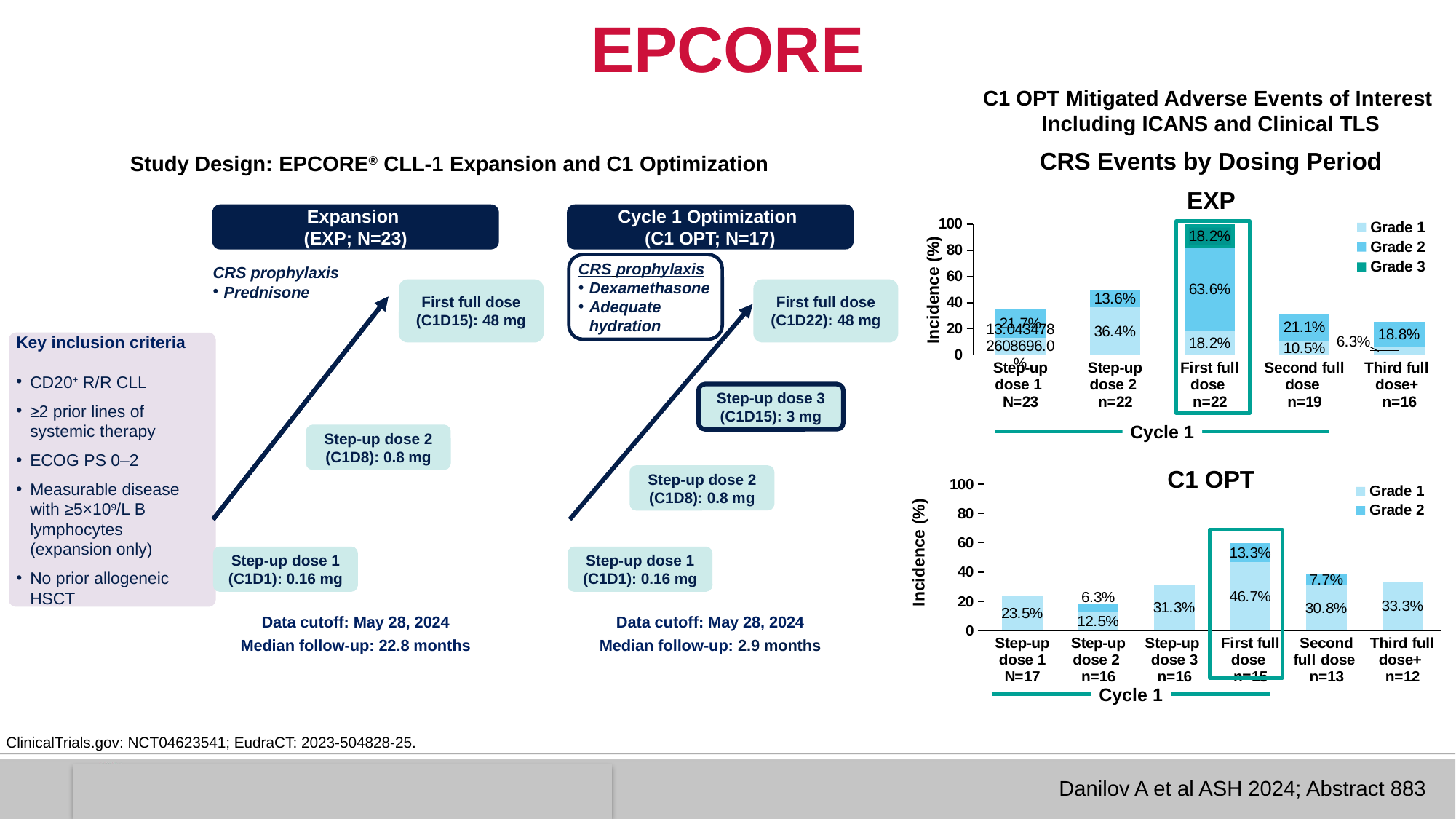
In the EXP chart, what is the difference in Grade 2 CRS incidence between the Second full dose and Step-up dose 2? 7.5 percentage points In the C1 OPT chart, which has the larger Grade 1 CRS incidence: Step-up dose 1 or Step-up dose 3? Step-up dose 3 How many grades does the legend of the C1 OPT chart list? 2 In the C1 OPT chart, what is the Grade 1 CRS incidence at the First full dose? 46.7% How many dosing periods are shown on the x axis of the C1 OPT chart? 6 In the EXP chart, what is the Grade 3 CRS incidence at the First full dose? 18.2% In the C1 OPT chart, what is the total CRS incidence (Grade 1 plus Grade 2) at the First full dose? 60.0% How many dosing periods are shown on the x axis of the EXP chart? 5 How many grades does the legend of the EXP chart list? 3 In the EXP chart, what is the Grade 2 CRS incidence at the First full dose? 63.6% In the C1 OPT chart, which dosing period has the highest Grade 1 CRS incidence? First full dose What type of chart is used for the CRS Events by Dosing Period data? Stacked bar chart